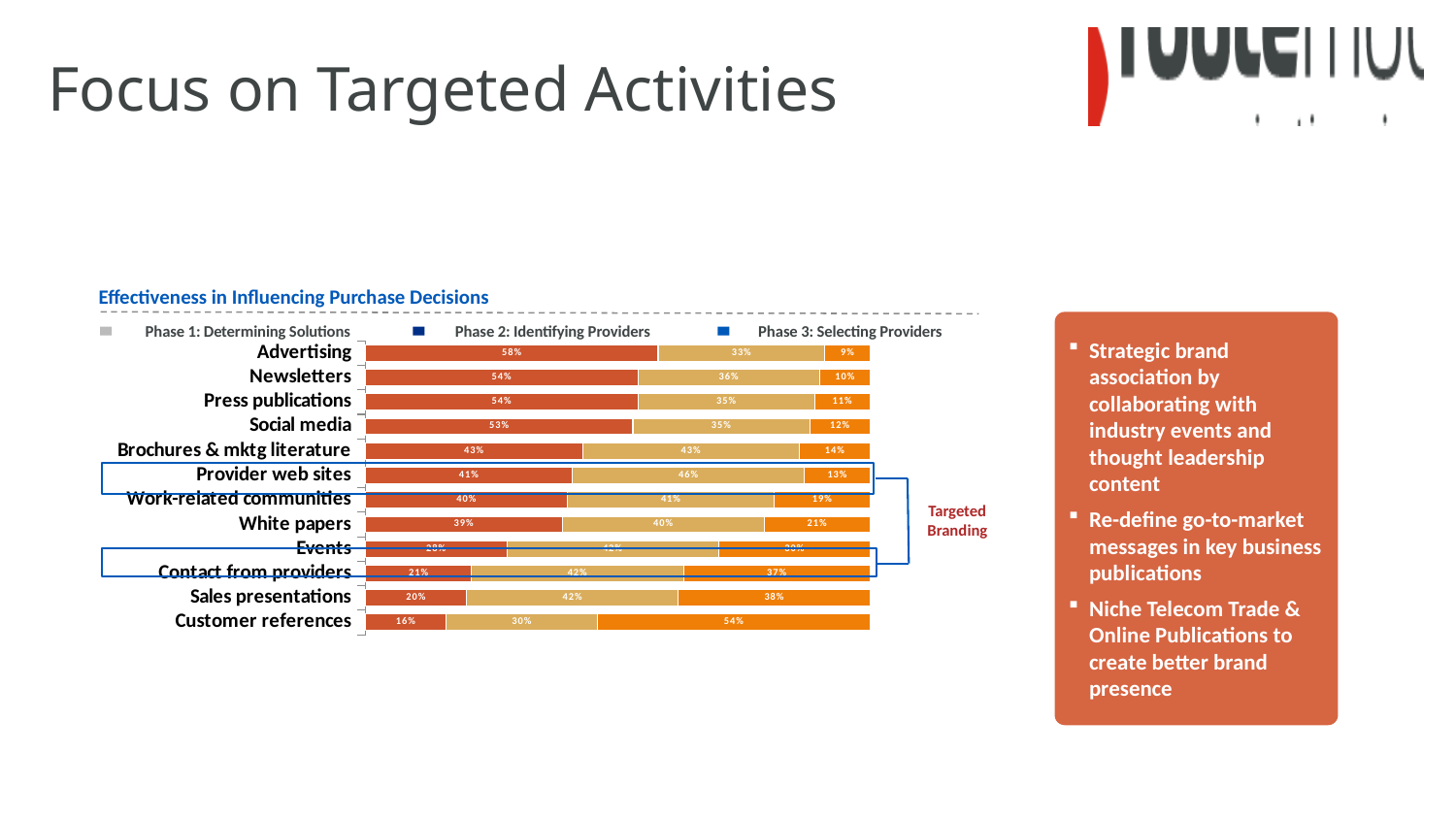
How many categories are plotted in the chart? 12 What is the Phase 2: Identifying Providers value for Provider web sites? 46% What is the difference between the Phase 3: Selecting Providers values for Customer references and Advertising? 45% What is the title of the chart? Effectiveness in Influencing Purchase Decisions Which category has the lowest Phase 1: Determining Solutions value? Customer references What is the total of the stacked bar for Sales presentations? 100% Which is larger: the Phase 2: Identifying Providers value for White papers or for Customer references? White papers What kind of chart is shown on the slide? Stacked bar chart How many series does the chart's legend list? 3 Which category has the highest Phase 1: Determining Solutions value? Advertising What is the Phase 3: Selecting Providers value for Customer references? 54% What is the Phase 1: Determining Solutions value for Advertising? 58%